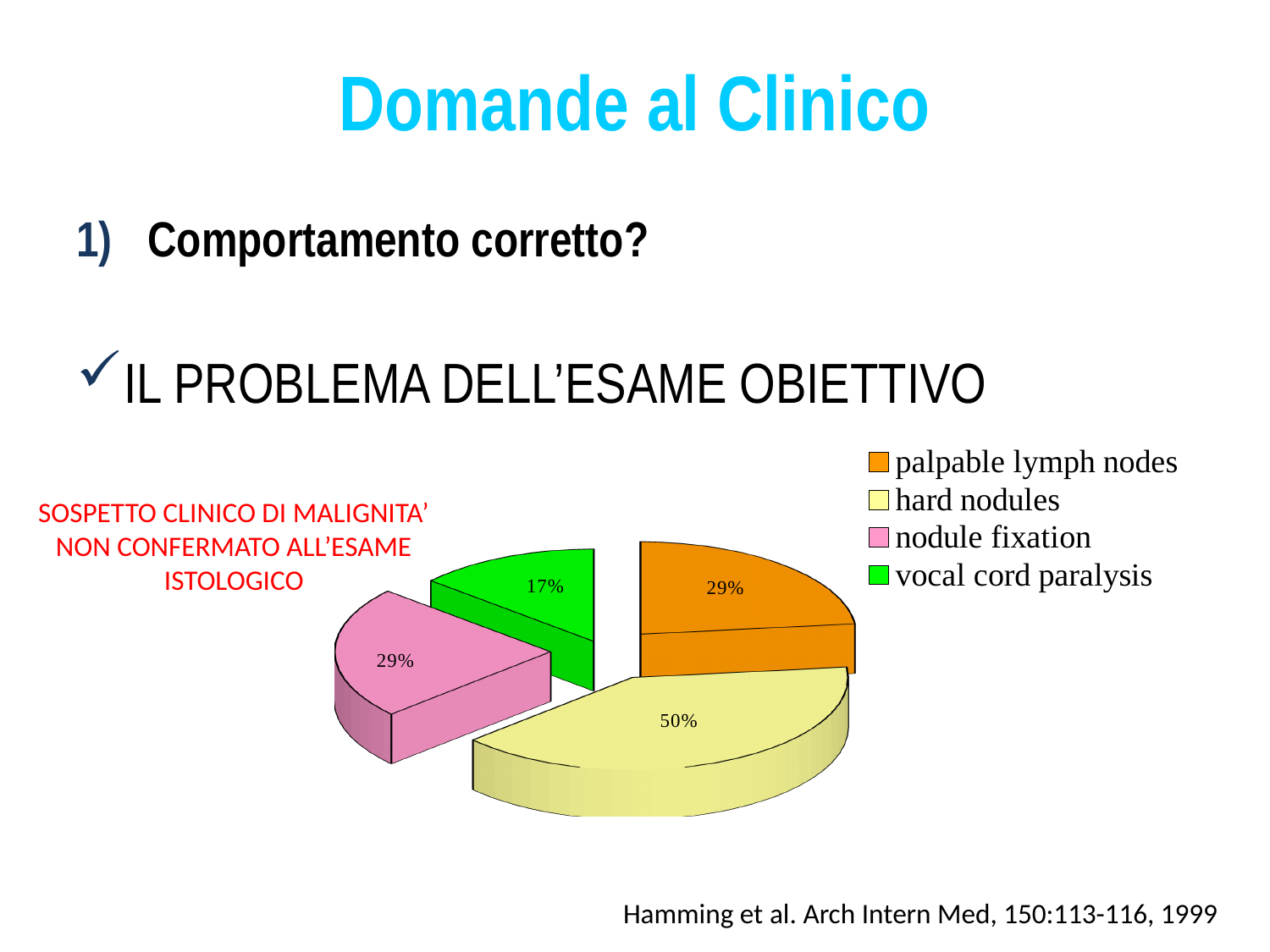
What kind of chart is shown on the slide? pie chart How many categories does the pie chart show? 4 Which category has the largest slice of the pie? hard nodules What colour is the slice for nodule fixation? pink What percentage is shown for nodule fixation? 29% What percentage is shown for palpable lymph nodes? 29% Which legend entry is shown in green? vocal cord paralysis Which category has the smallest slice of the pie? vocal cord paralysis What percentage is shown for hard nodules? 50% Which is larger, the slice for hard nodules or the slice for vocal cord paralysis? hard nodules What is the difference in percentage points between hard nodules and vocal cord paralysis? 33 What percentage is shown for vocal cord paralysis? 17%